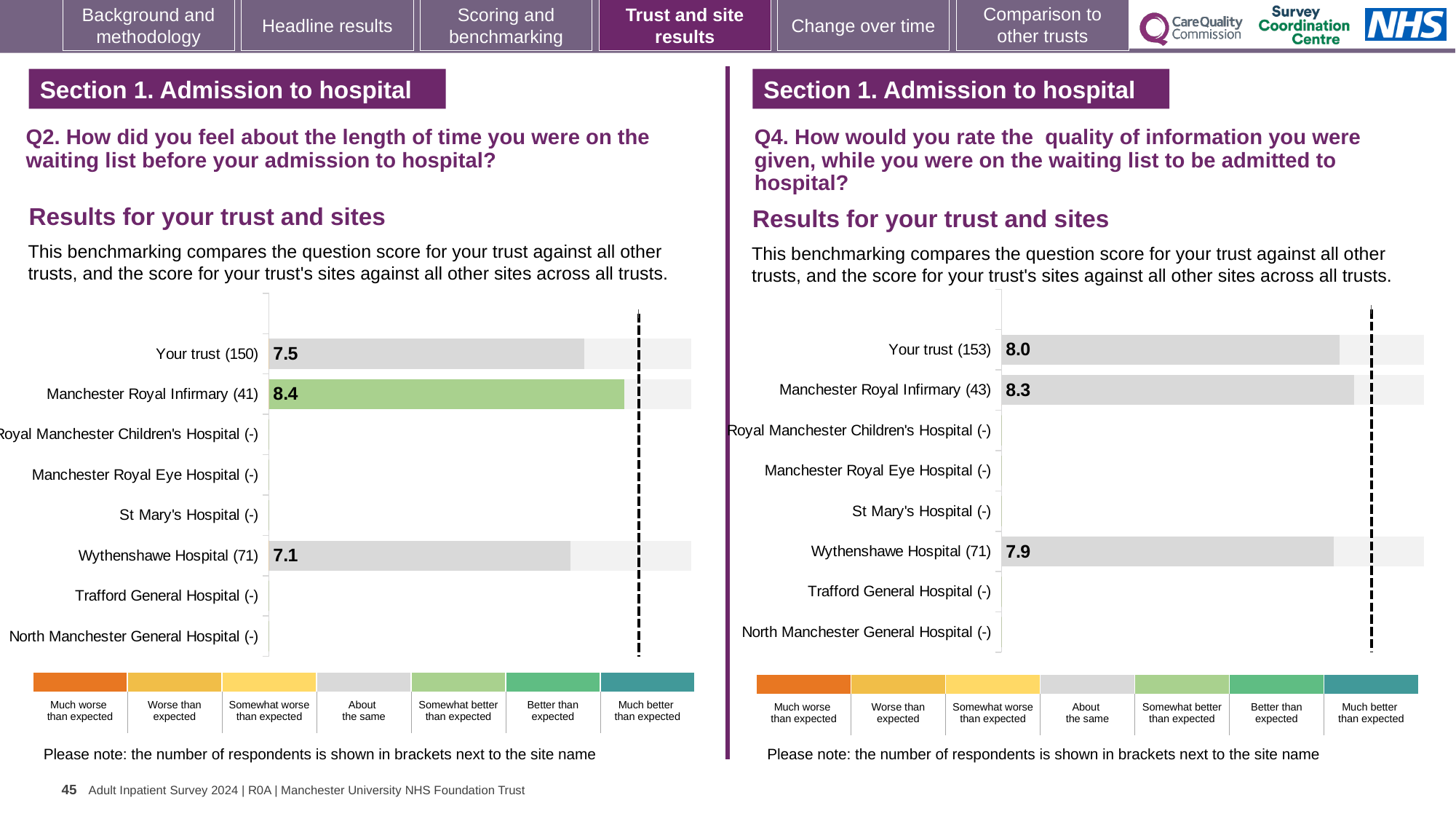
On the Q4 chart (right), what is the difference between the Manchester Royal Infirmary score and the Your trust score? 0.3 On the Q4 chart (right), what is the score for Wythenshawe Hospital? 7.9 On the Q2 chart (left), what is the score for Your trust? 7.5 How many site rows (including Your trust) are listed on the Q4 chart (right)? 8 On the Q4 chart (right), which site has the lowest score among those with a value shown? Wythenshawe Hospital On the Q2 chart (left), which site has the highest score? Manchester Royal Infirmary On the Q2 chart (left), what is the score for Wythenshawe Hospital? 7.1 On the Q2 chart (left), what is the difference between the Manchester Royal Infirmary score and the Wythenshawe Hospital score? 1.3 On the Q4 chart (right), what is the score for Your trust? 8.0 On the Q2 chart (left), what is the score for Manchester Royal Infirmary? 8.4 On the Q2 chart (left), which is larger: the score for Your trust or the score for Wythenshawe Hospital? Your trust What type of chart is used on the Q2 chart (left)? Bar chart